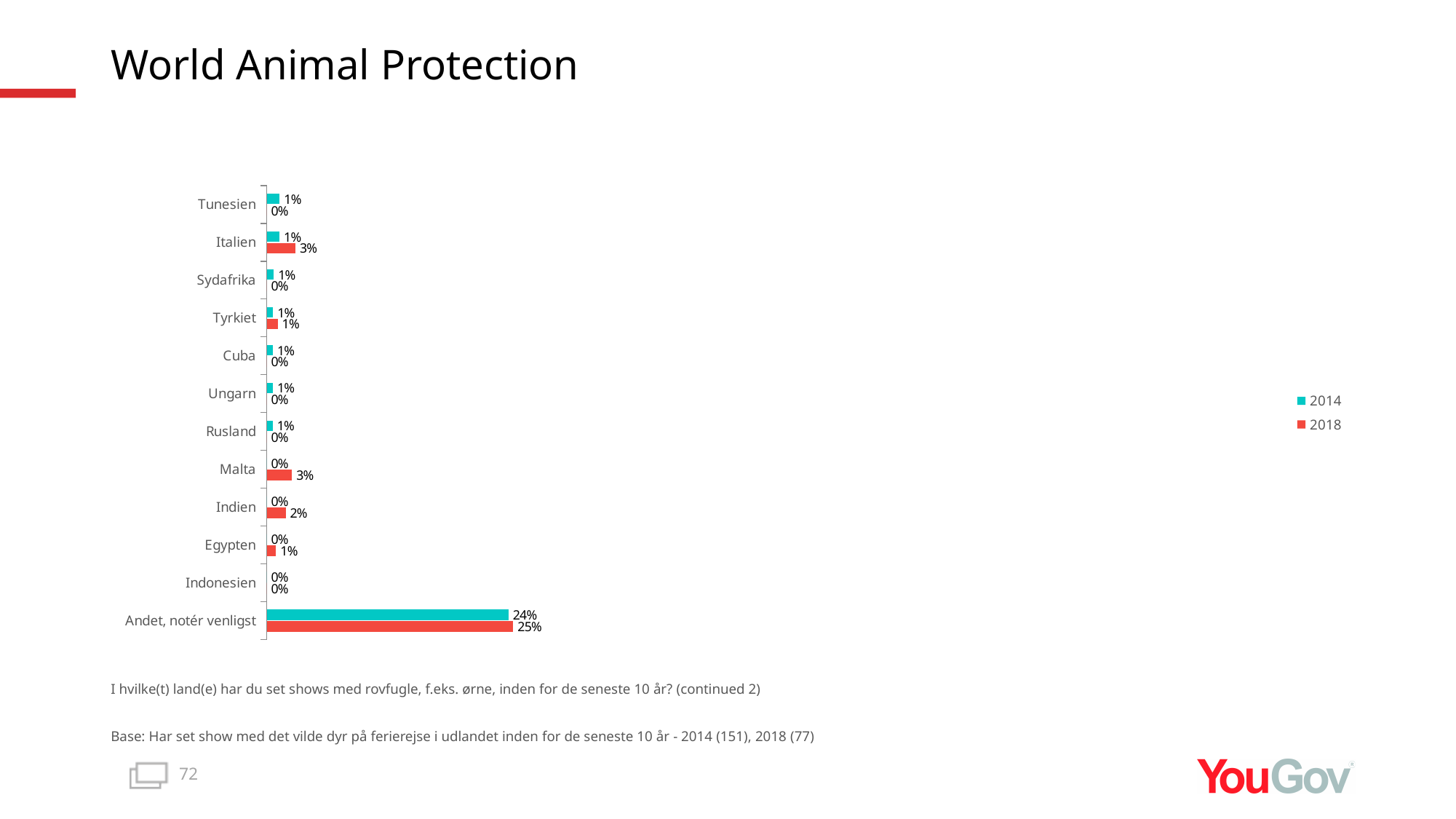
What is the 2018 value for Italien? 3% What is the 2014 value for Malta? 0% What is the 2014 value for Andet, notér venligst? 24% What kind of chart is shown on the slide? Bar chart How many series does the legend list? 2 What is the 2018 value for Indien? 2% What is the difference between the 2018 and 2014 values for Andet, notér venligst? 1% How many categories are shown on the chart? 12 Which series is shown in red? 2018 Which is larger for Tunesien: the 2014 value or the 2018 value? 2014 Which is larger for Malta: the 2014 value or the 2018 value? 2018 Which category has the highest 2018 value? Andet, notér venligst